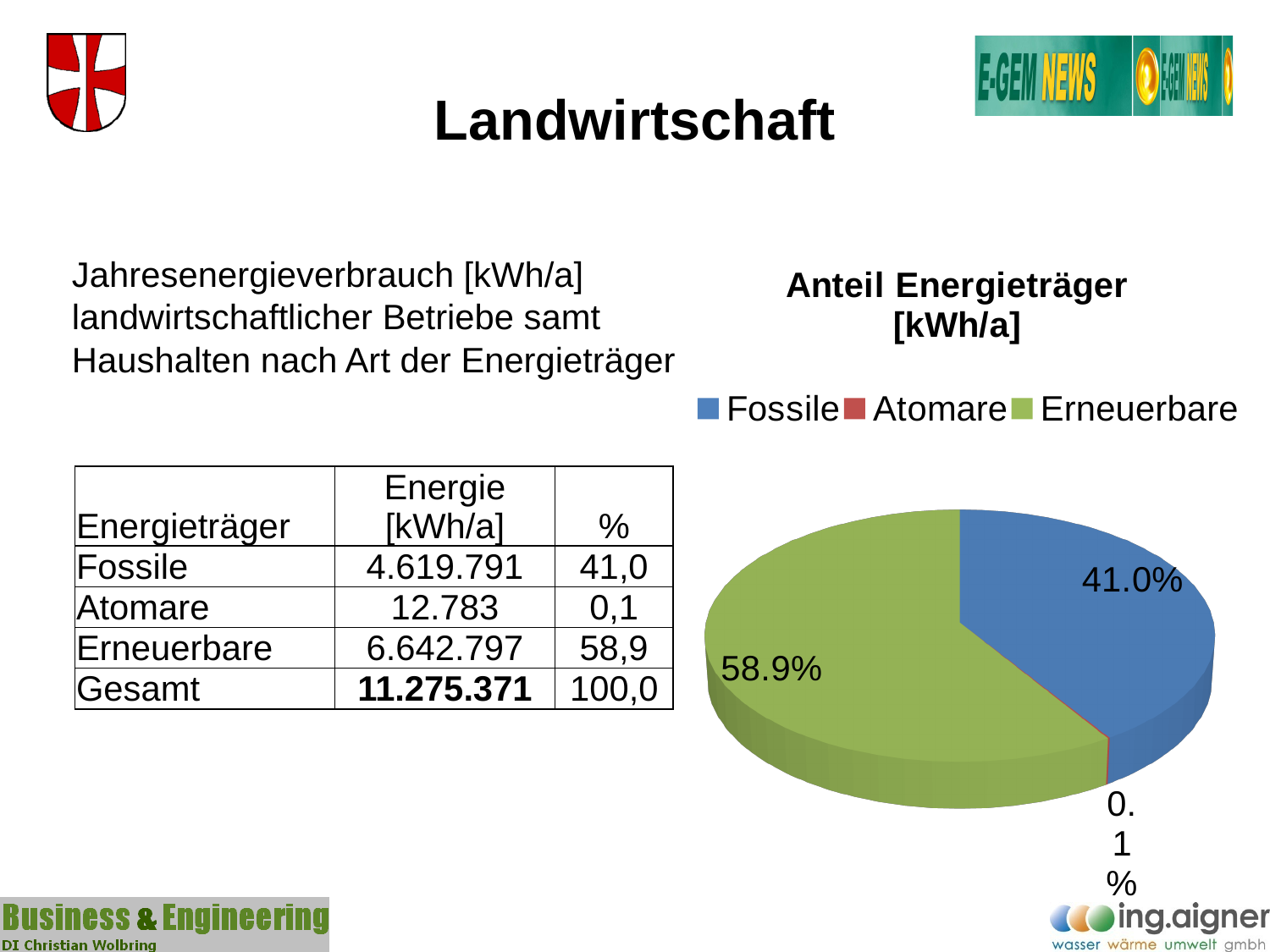
Which colour represents Erneuerbare in the chart? green What is the difference in percentage points between the Erneuerbare and Fossile slices? 17.9 Which category has the smallest slice of the pie? Atomare How many slices does the pie chart have? 3 What is the title of the chart? Anteil Energieträger [kWh/a] Which category has the largest slice of the pie? Erneuerbare What share of the pie does Erneuerbare have? 58.9% Which slice is larger, Fossile or Erneuerbare? Erneuerbare What share of the pie does Atomare have? 0.1% What share of the pie does Fossile have? 41.0% How many entries does the chart legend list? 3 What kind of chart is shown on the slide? pie chart